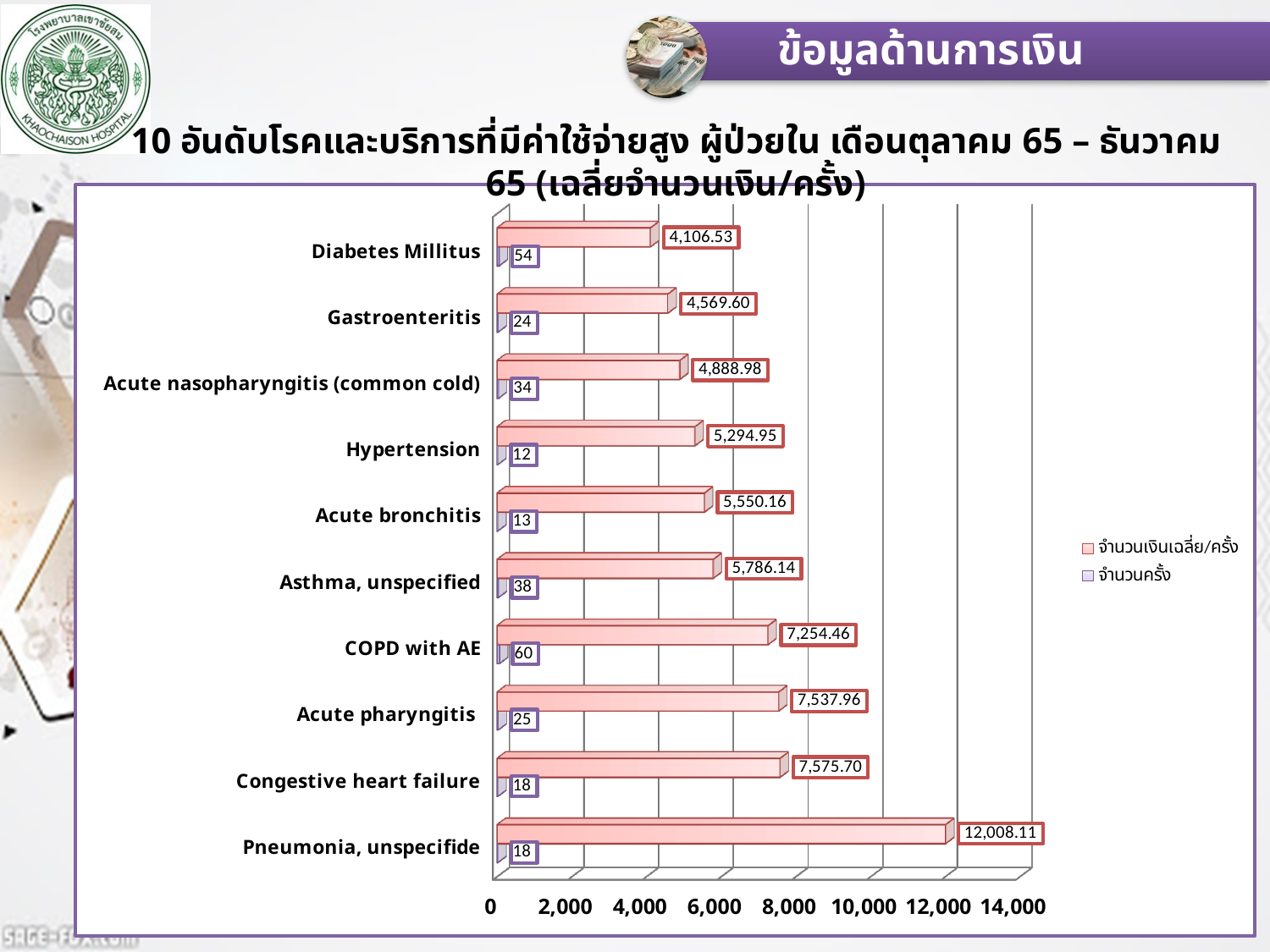
How many series does the legend list? 2 Which disease has the lowest number of visits (จำนวนครั้ง)? Hypertension What is the number of visits (จำนวนครั้ง) for COPD with AE? 60 What is the difference in average amount per visit between Pneumonia, unspecifide and Congestive heart failure? 4,432.41 What is the average amount per visit for Hypertension? 5,294.95 Which disease has the highest average amount per visit? Pneumonia, unspecifide What is the average amount per visit (จำนวนเงินเฉลี่ย/ครั้ง) for Pneumonia, unspecifide? 12,008.11 What type of chart is shown on the slide? Bar chart Is the average amount per visit for COPD with AE greater or less than 6,000? greater Which disease has the lowest average amount per visit? Diabetes Millitus Which has a higher average amount per visit, Asthma, unspecified or Acute bronchitis? Asthma, unspecified How many diseases are listed on the chart? 10